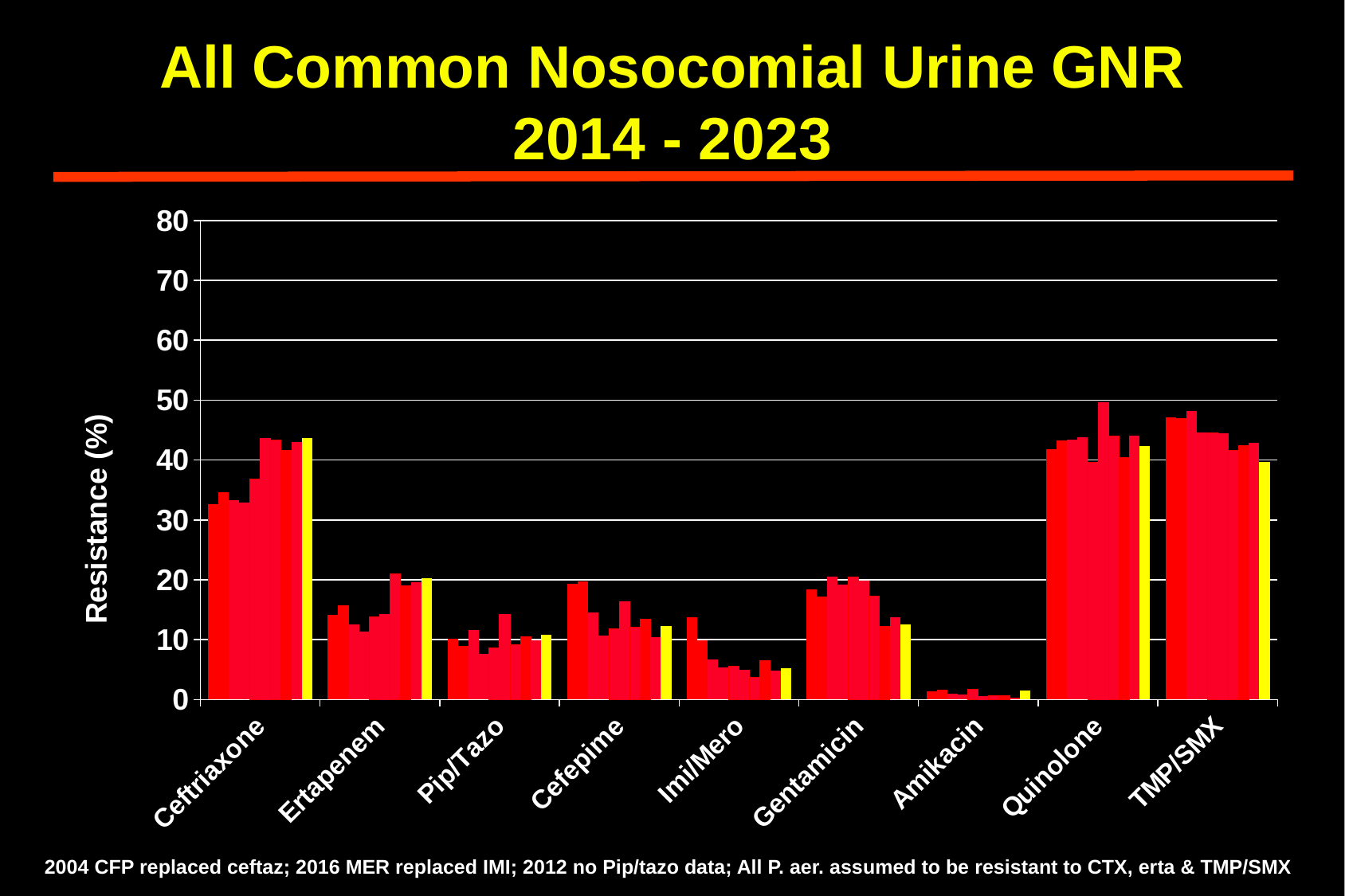
Which has higher resistance values, Ceftriaxone or Ertapenem? Ceftriaxone Is the value of the yellow (last) bar for Quinolone greater or less than 40? greater Is the value of the yellow (last) bar for Imi/Mero greater or less than 10? less Are all the bars for Amikacin greater or less than 10? less What is the label on the y axis? Resistance (%) Do the resistance values for Imi/Mero rise or fall across the bars from left to right? fall How many bars are plotted for each antibiotic category? 10 Which antibiotic category has the lowest resistance values? Amikacin What is the title of the chart? All Common Nosocomial Urine GNR 2014 - 2023 What kind of chart is shown on the slide? bar chart How many antibiotic categories are shown on the x axis? 9